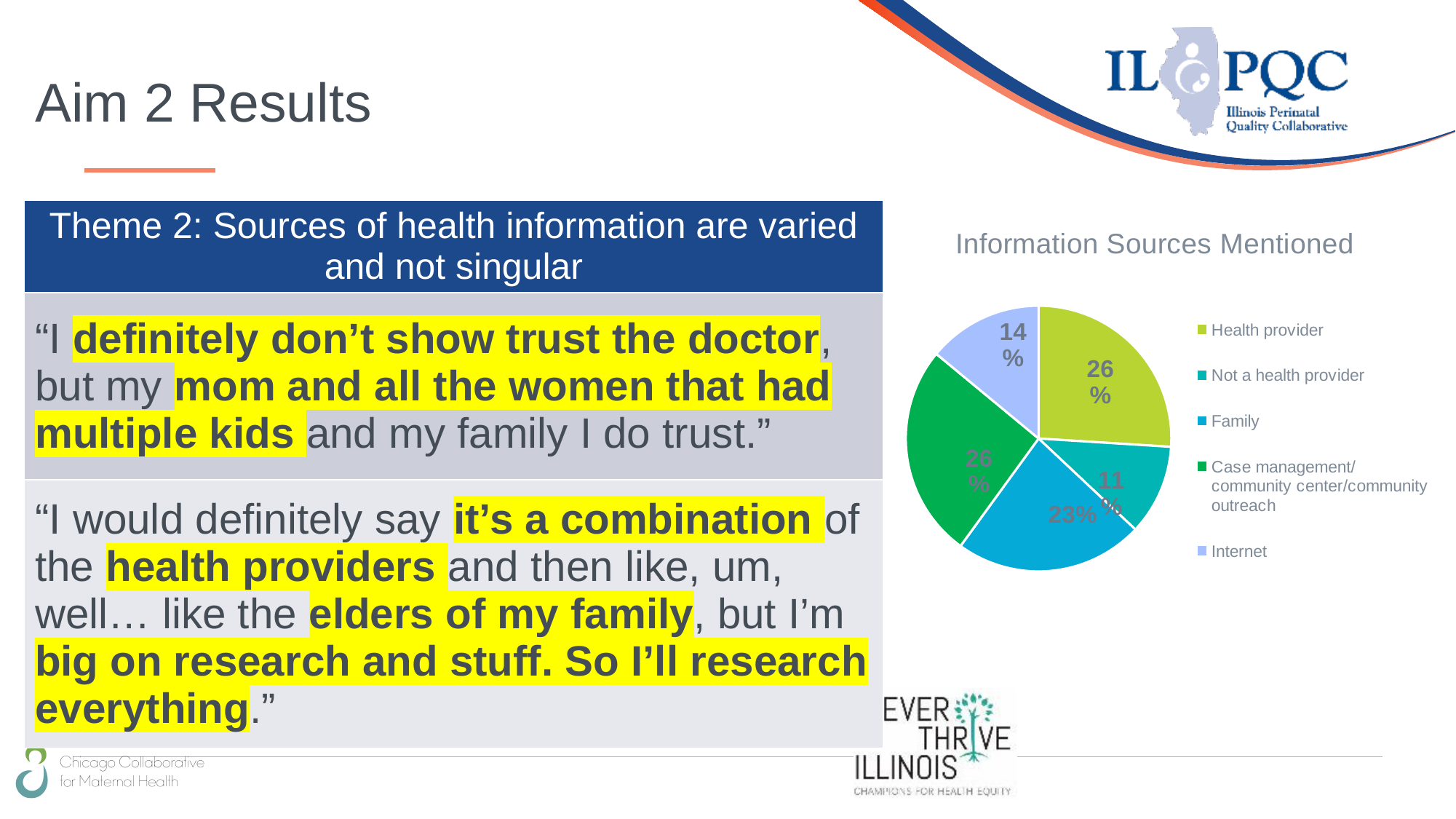
Which legend entry is shown in light blue? Internet Which is larger, the share for Family or the share for Internet? Family What share of the pie does Health provider account for? 26% What share of the pie does Case management/community center/community outreach account for? 26% What is the title of the pie chart? Information Sources Mentioned What type of chart is shown on the slide? pie chart What share of the pie does Not a health provider account for? 11% How many categories does the legend of the pie chart list? 5 Which category has the smallest slice of the pie? Not a health provider What is the difference in percentage points between the Health provider share and the Not a health provider share? 15